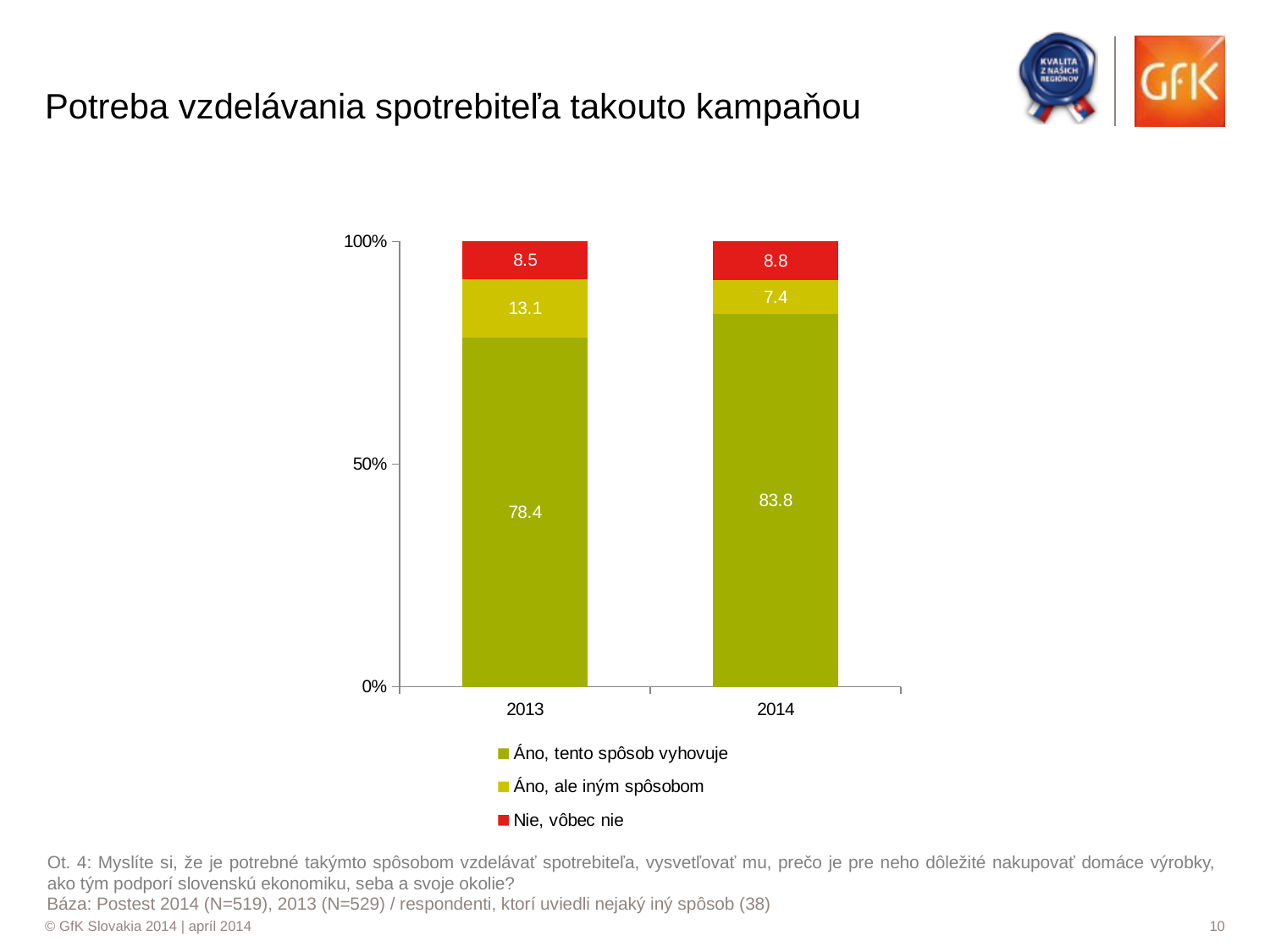
How many categories are shown on the x axis? 2 What is the value for "Nie, vôbec nie" in 2014? 8.8 Which colour represents "Nie, vôbec nie" in the chart? red What is the value for "Áno, ale iným spôsobom" in 2013? 13.1 What is the value for "Áno, tento spôsob vyhovuje" in 2013? 78.4 What is the value for "Áno, tento spôsob vyhovuje" in 2014? 83.8 What kind of chart is shown on the slide? stacked bar chart Does the value for "Áno, ale iným spôsobom" rise or fall from 2013 to 2014? fall Is the value for "Áno, tento spôsob vyhovuje" in 2013 greater or less than 50%? greater What is the difference between the "Áno, ale iným spôsobom" values for 2013 and 2014? 5.7 Which year has the higher value for "Áno, tento spôsob vyhovuje"? 2014 How many series does the legend list? 3